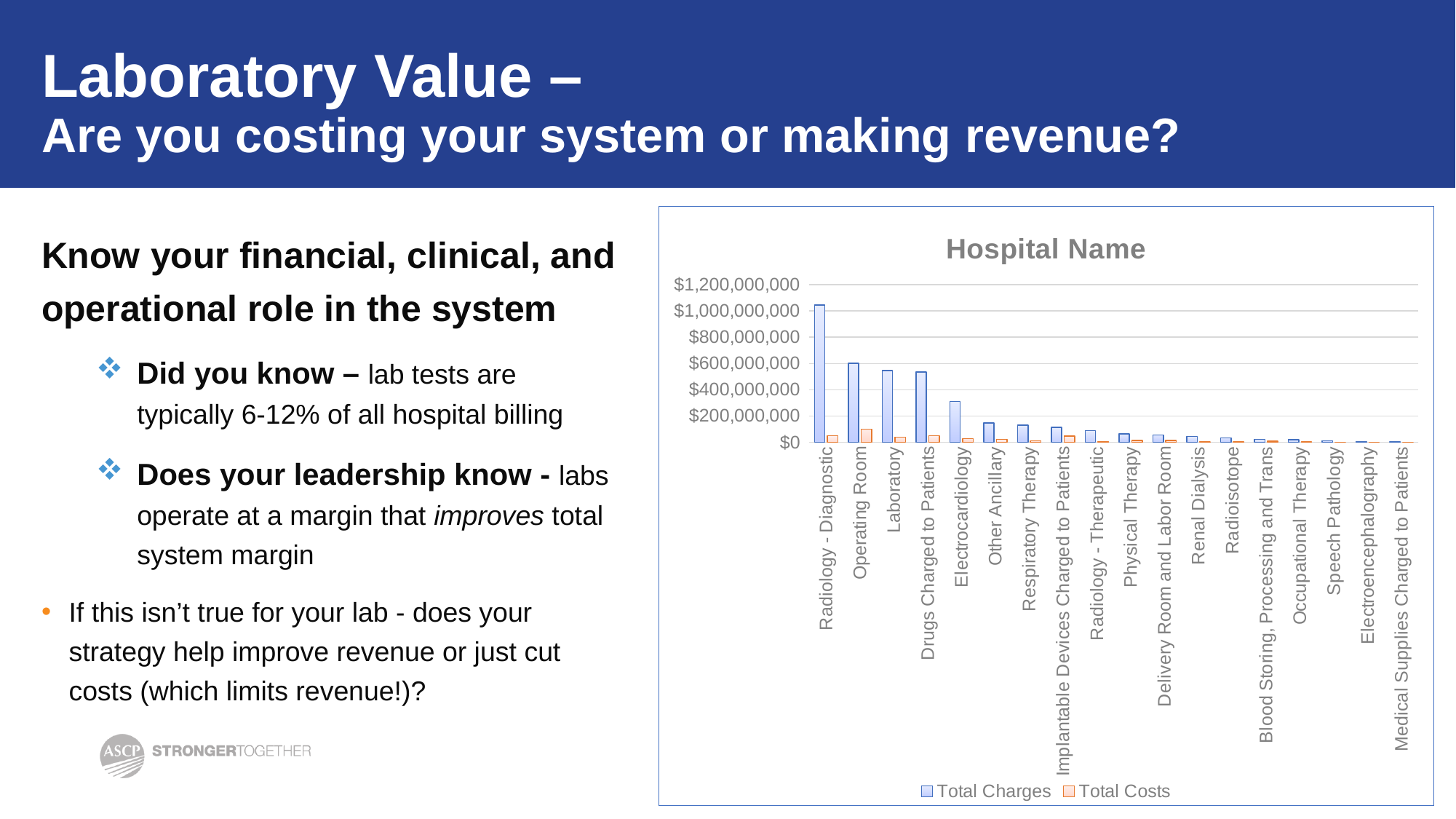
How many series does the chart legend list? 2 Is the Total Charges value for Electrocardiology greater or less than $400,000,000? less How many categories are shown on the x axis of the chart? 18 What type of chart is shown on the slide? Bar chart Which category has the highest Total Costs? Operating Room Do the Total Charges values generally rise or fall moving left to right along the x axis? Fall What is the title of the chart? Hospital Name Is the Total Charges value for Laboratory greater or less than $400,000,000? greater Which category has the highest Total Charges? Radiology - Diagnostic What are the two series named in the chart legend? Total Charges and Total Costs Which has larger Total Charges, Radiology - Diagnostic or Operating Room? Radiology - Diagnostic Is the Total Charges value for Radiology - Diagnostic greater or less than $800,000,000? greater